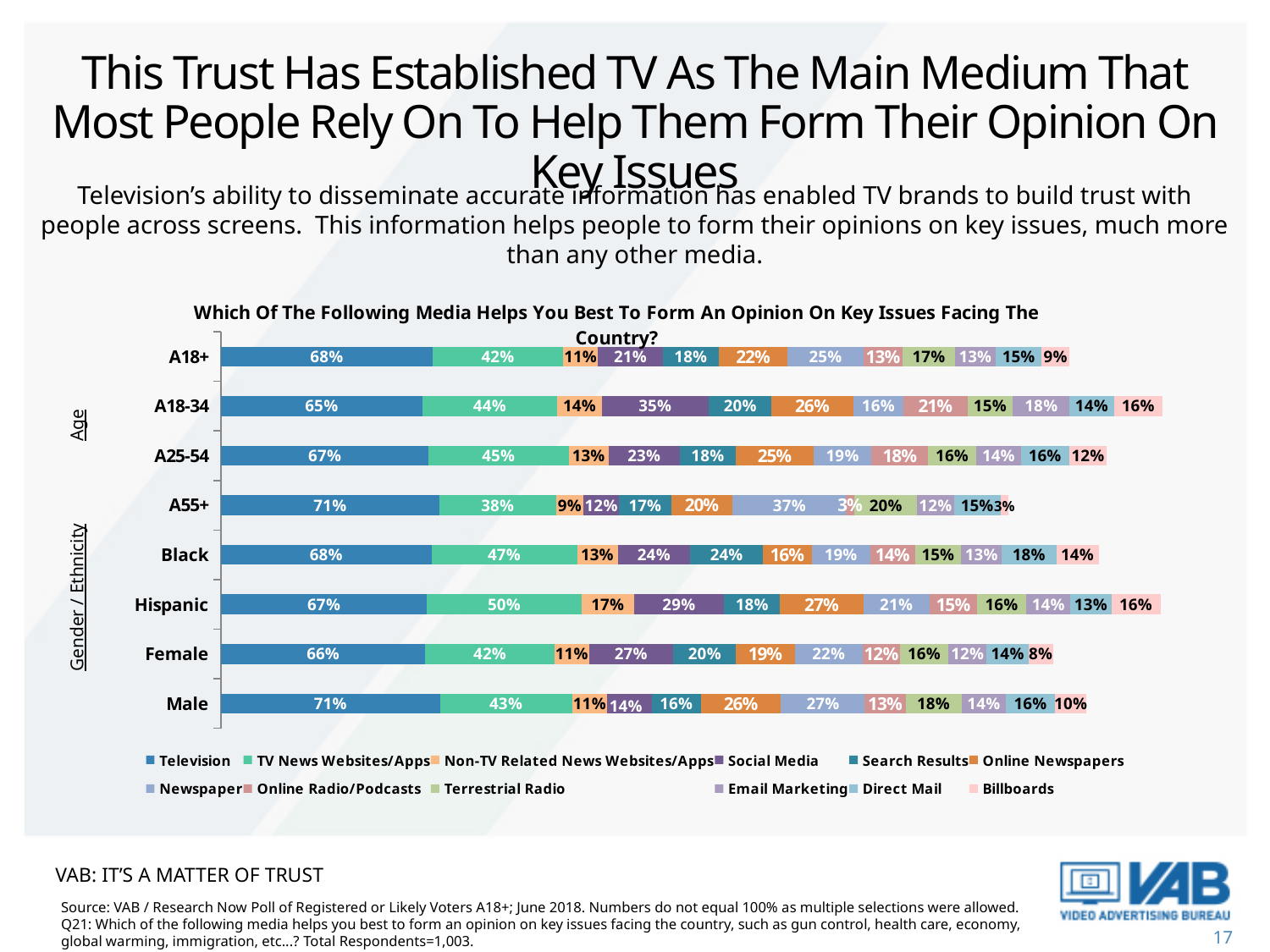
Which group has the lowest Television value? A18-34 What is the Social Media value for the A18-34 group? 35% What is the total of all segments in the A18+ bar? 274% What is the TV News Websites/Apps value for Hispanic respondents? 50% What is the Newspaper value for the A55+ group? 37% How many respondent groups are shown on the chart? 8 Which group has the highest value for TV News Websites/Apps? Hispanic How many media types does the legend list? 12 What is the difference between the Television value for A18+ and the Television value for Female respondents? 2% What percentage of A55+ respondents selected Television as the medium that helps them best form an opinion? 71% Which group has a larger Social Media value, A18-34 or A55+? A18-34 What type of chart is shown on the slide? Stacked bar chart